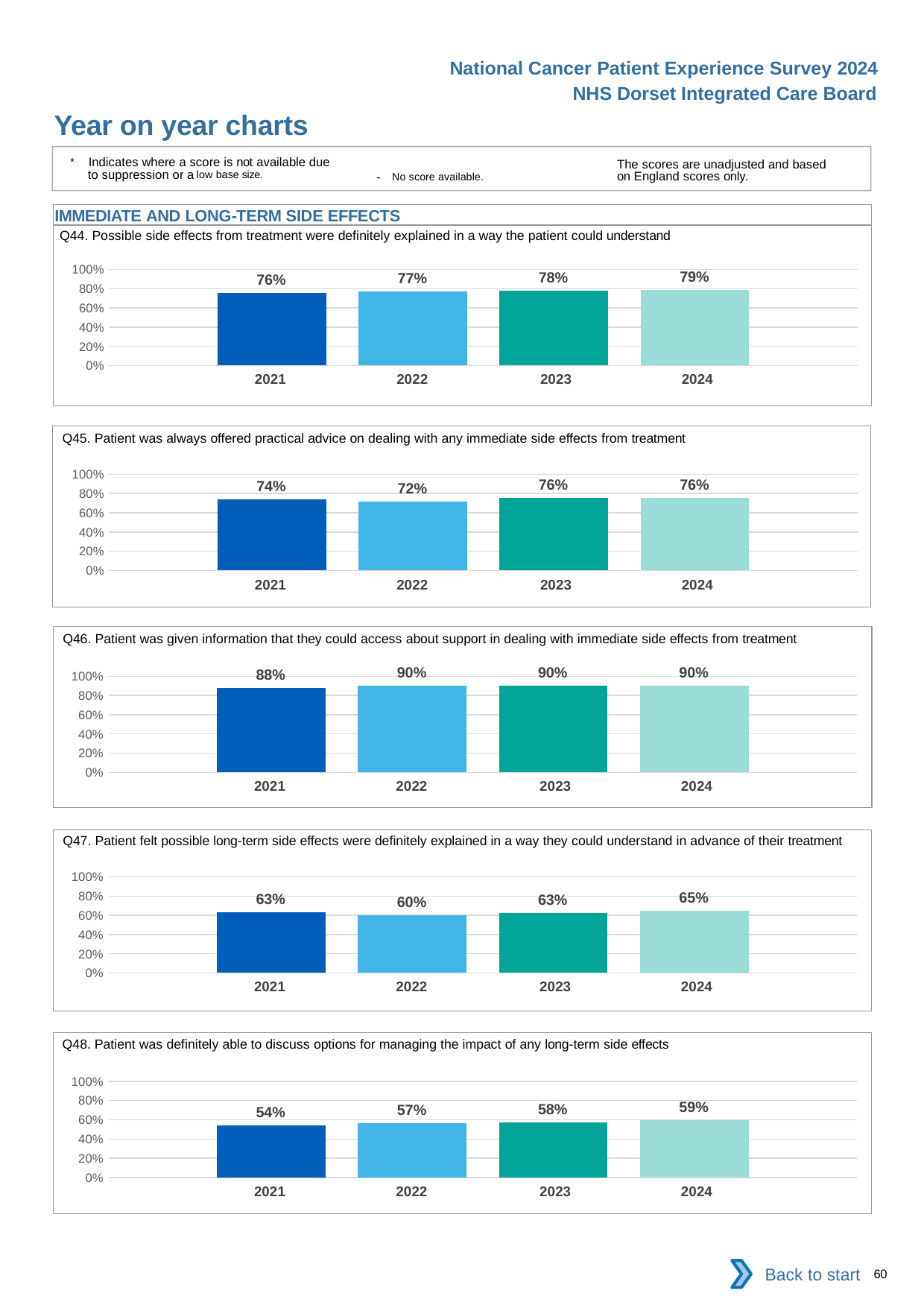
In the Q45 chart, which year has the lowest value? 2022 In the Q47 chart, which is larger, the value for 2021 or the value for 2022? 2021 In the Q46 chart, what is the value for 2021? 88% In the Q44 chart, what is the value for 2024? 79% In the Q44 chart, do the values rise or fall from 2021 to 2024? rise What kind of chart is the Q46 chart? bar chart In the Q47 chart, what is the difference between the 2024 value and the 2022 value? 5% How many years are shown in the Q45 chart? 4 In the Q48 chart, is the value for 2021 greater or less than 60%? less What is the section heading above the Q44 chart? IMMEDIATE AND LONG-TERM SIDE EFFECTS In the Q45 chart, what is the value for 2023? 76% In the Q48 chart, which year has the highest value? 2024